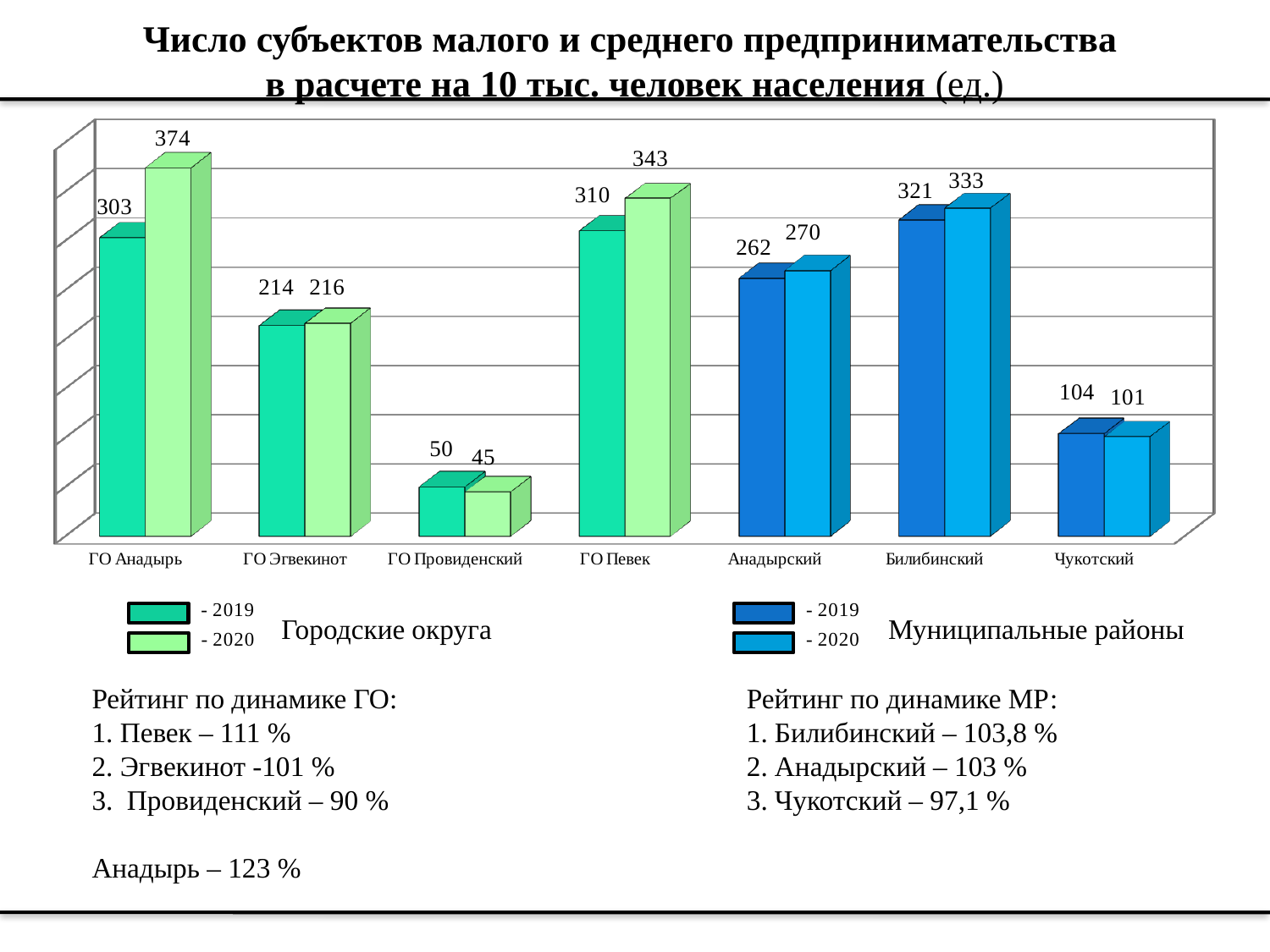
Which two years are listed in the chart legend? 2019 and 2020 What is the 2020 value for ГО Анадырь? 374 How many categories (territories) are shown on the x axis? 7 What kind of chart is shown on the slide? bar chart What is the difference between the 2020 and 2019 values for ГО Певек? 33 Which category has the lowest 2019 value? ГО Провиденский What is the 2020 value for ГО Провиденский? 45 What is the 2019 value for Билибинский? 321 Which category has the highest 2020 value? ГО Анадырь How many years does the chart compare for each territory? 2 Which is larger: the 2019 value for Анадырский or the 2019 value for ГО Певек? ГО Певек By how much did the value for ГО Анадырь increase from 2019 to 2020? 71